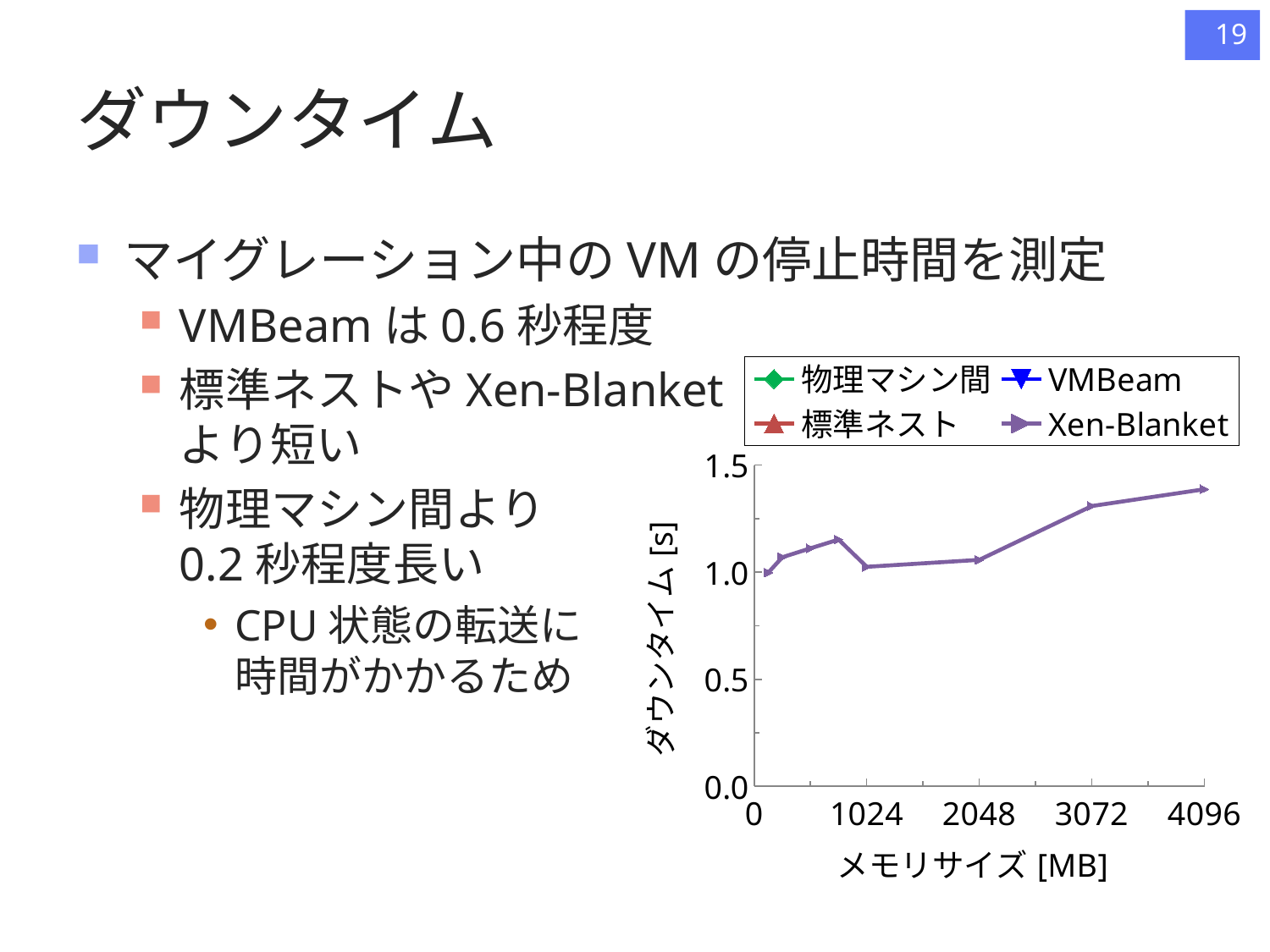
What is the label of the y axis? ダウンタイム [s] For the Xen-Blanket series, which memory size has the highest downtime? 4096 How many series does the legend list? 4 Is the Xen-Blanket downtime at 2048 MB greater or less than 1.5? less Is the Xen-Blanket downtime at 4096 MB greater or less than 1.0? greater What kind of chart is shown on the slide? line chart For the Xen-Blanket series, is the downtime larger at 4096 MB or at 1024 MB? 4096 MB Is the Xen-Blanket downtime at 3072 MB greater or less than 1.0? greater What is the largest memory size shown on the x axis? 4096 Which series are listed in the legend? 物理マシン間, VMBeam, 標準ネスト, Xen-Blanket Does the Xen-Blanket downtime generally rise or fall as memory size increases from 1024 MB to 4096 MB? rise